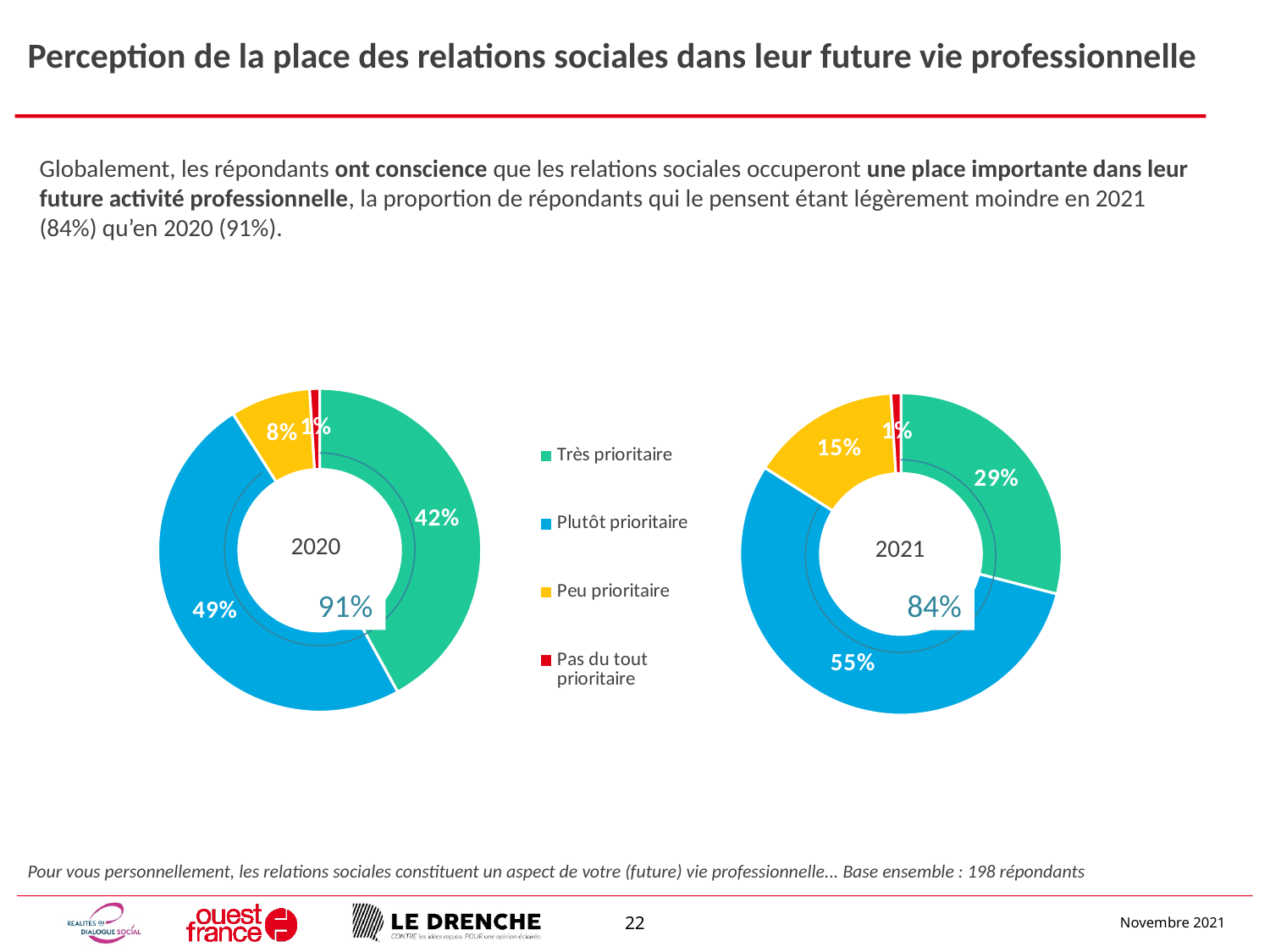
How many categories does the legend list? 4 In the 2020 chart, what share of respondents answered "Plutôt prioritaire"? 49% In the 2020 chart, what share of respondents answered "Pas du tout prioritaire"? 1% What is the difference between the "Plutôt prioritaire" share in 2021 and in 2020? 6 percentage points In the 2021 chart, what share of respondents answered "Très prioritaire"? 29% In the 2021 chart, what share of respondents answered "Peu prioritaire"? 15% What type of chart is used on this slide? Donut (pie) chart Which is larger: the "Très prioritaire" share in 2020 or in 2021? 2020 In the 2021 chart, which category has the smallest share? Pas du tout prioritaire In the 2020 chart, which category has the largest share? Plutôt prioritaire Which colour represents "Peu prioritaire" in the charts? Yellow What percentage is shown in the centre of the 2021 chart? 84%